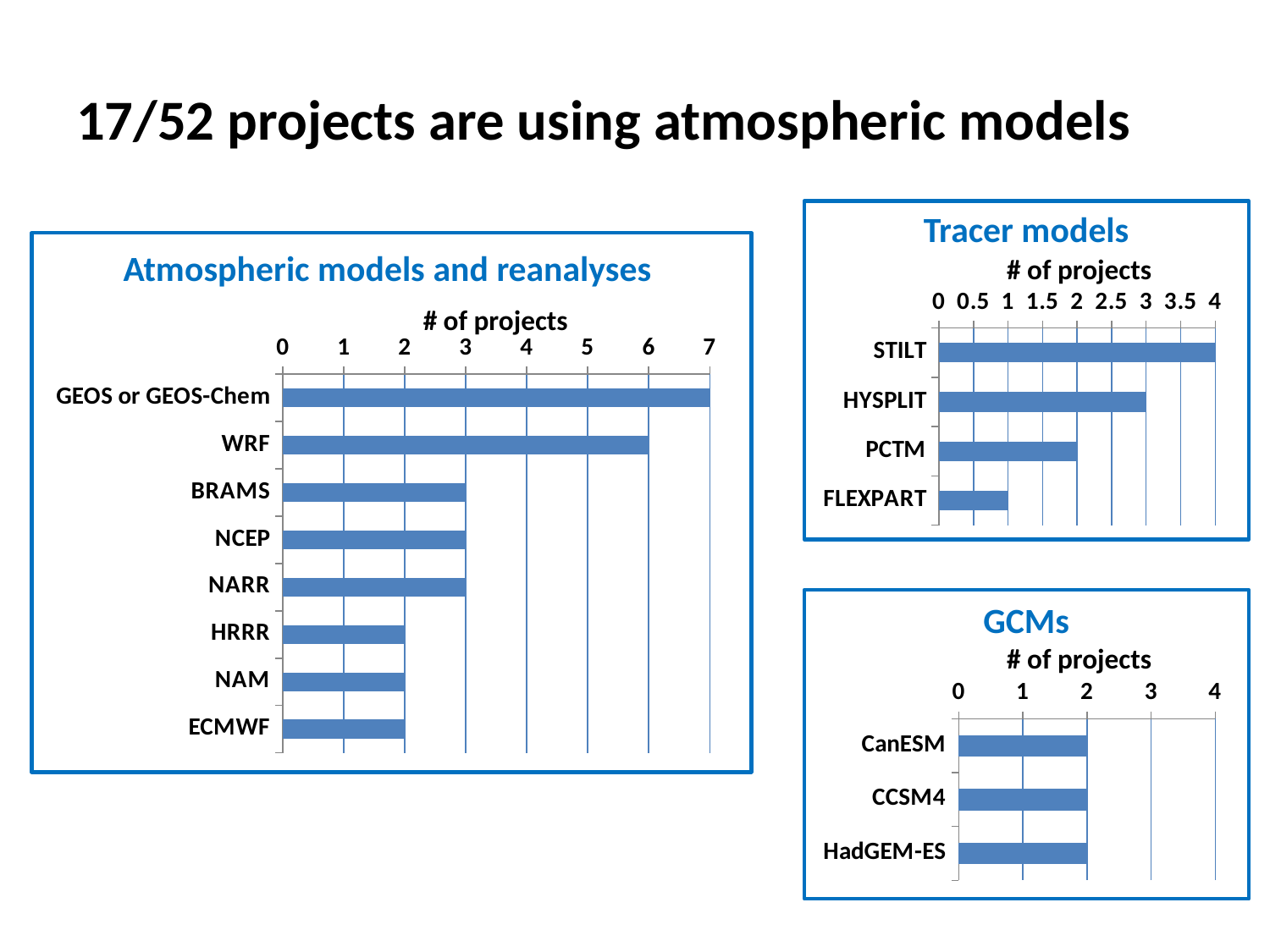
What type of chart is the 'GCMs' chart? Bar chart In the 'Tracer models' chart, what is the difference in number of projects between STILT and FLEXPART? 3 In the 'Tracer models' chart, which has more projects, HYSPLIT or PCTM? HYSPLIT In the 'Atmospheric models and reanalyses' chart, what is the difference in number of projects between GEOS or GEOS-Chem and WRF? 1 In the 'Tracer models' chart, how many projects use STILT? 4 In the 'GCMs' chart, how many projects use CCSM4? 2 In the 'Atmospheric models and reanalyses' chart, which model has the highest number of projects? GEOS or GEOS-Chem In the 'Atmospheric models and reanalyses' chart, how many projects use GEOS or GEOS-Chem? 7 In the 'Tracer models' chart, which model has the lowest number of projects? FLEXPART In the 'Atmospheric models and reanalyses' chart, is the value for WRF greater or less than 5? greater In the 'GCMs' chart, how many models are listed? 3 In the 'Atmospheric models and reanalyses' chart, how many models are listed? 8